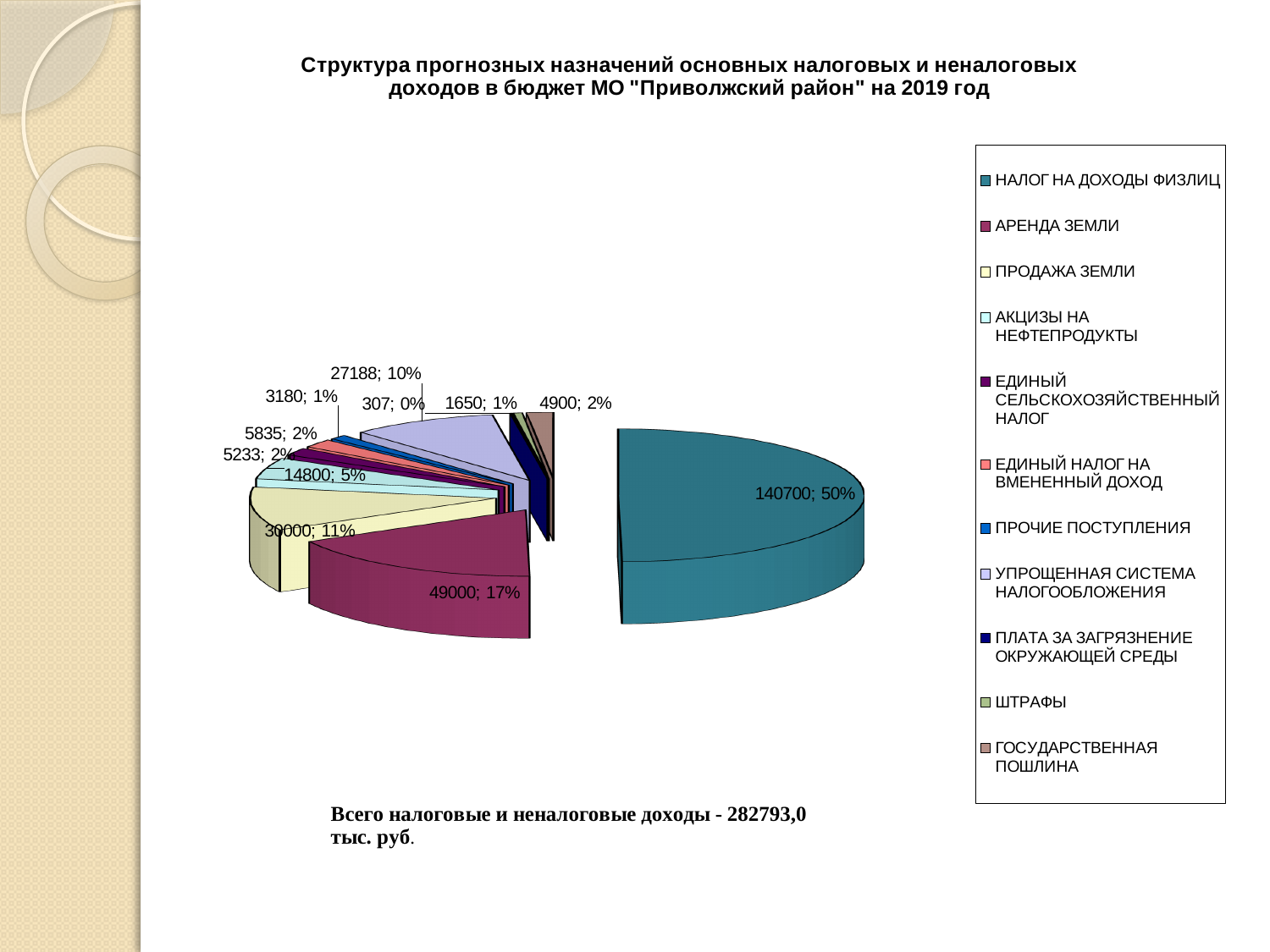
Which category has the largest slice of the pie? НАЛОГ НА ДОХОДЫ ФИЗЛИЦ According to the text below the chart, what is the total of tax and non-tax revenues in thousand rubles? 282793,0 What is the difference between the values for НАЛОГ НА ДОХОДЫ ФИЗЛИЦ and АРЕНДА ЗЕМЛИ? 91700 What value is shown for АРЕНДА ЗЕМЛИ? 49000 What value is shown for УПРОЩЕННАЯ СИСТЕМА НАЛОГООБЛОЖЕНИЯ? 27188 What share of the pie does НАЛОГ НА ДОХОДЫ ФИЗЛИЦ take? 50% Which is larger, the value for ПРОДАЖА ЗЕМЛИ or the value for АКЦИЗЫ НА НЕФТЕПРОДУКТЫ? ПРОДАЖА ЗЕМЛИ What kind of chart is shown on the slide? pie chart What value is shown for НАЛОГ НА ДОХОДЫ ФИЗЛИЦ? 140700 Which category has the smallest slice of the pie? ПЛАТА ЗА ЗАГРЯЗНЕНИЕ ОКРУЖАЮЩЕЙ СРЕДЫ What share of the pie does ПРОДАЖА ЗЕМЛИ take? 11% How many categories does the legend of the pie chart list? 11